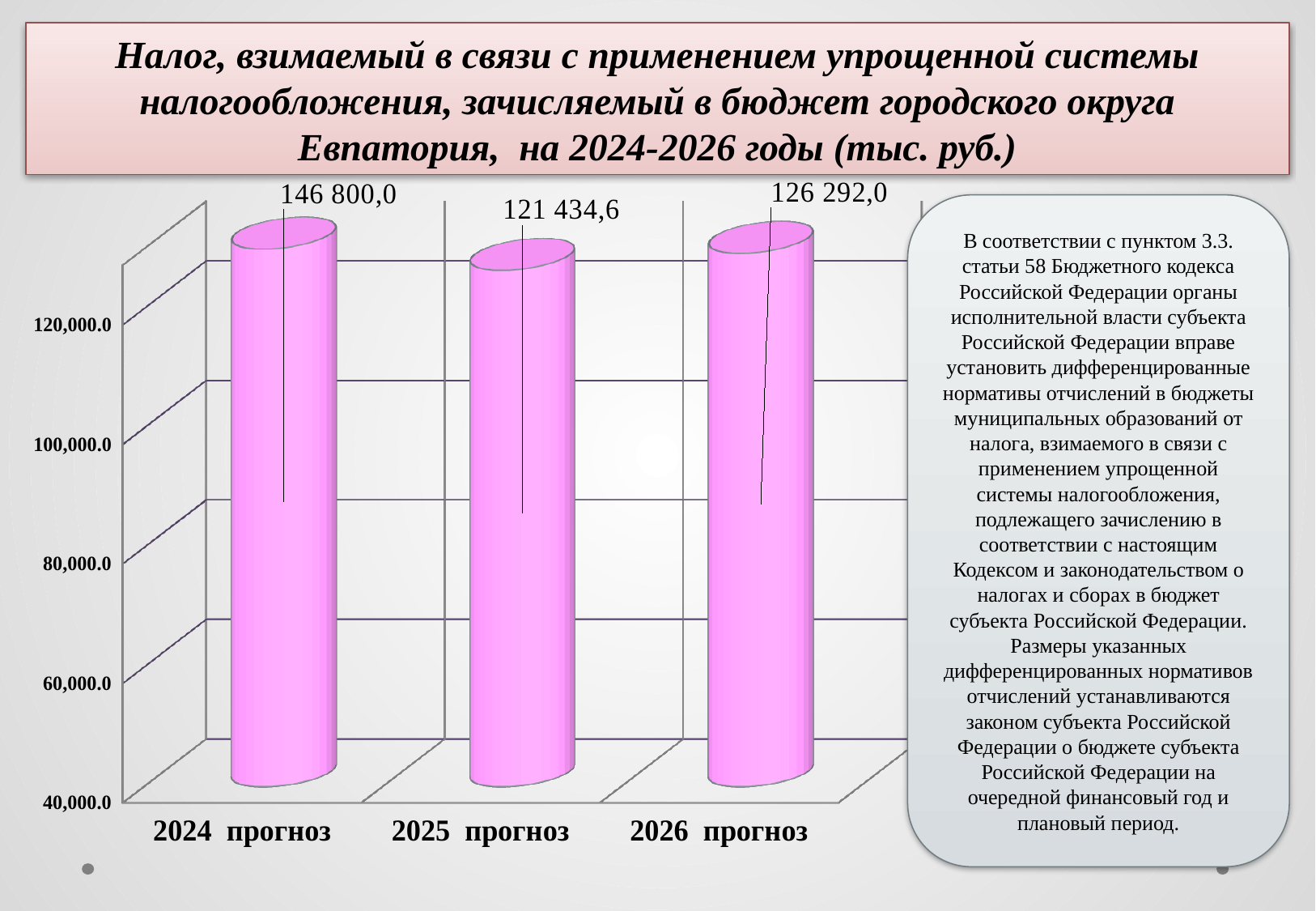
What is the value for 2026 прогноз? 126 292,0 Which category has the lowest value? 2025 прогноз Does the value rise or fall from 2024 прогноз to 2025 прогноз? fall What is the value for 2025 прогноз? 121 434,6 What is the difference between the values for 2026 прогноз and 2025 прогноз? 4 857,4 Is the value for 2024 прогноз greater or less than 120,000.0? greater Which is larger, the value for 2026 прогноз or the value for 2025 прогноз? 2026 прогноз What kind of chart is shown on the slide? bar chart What is the difference between the values for 2024 прогноз and 2025 прогноз? 25 365,4 Which category has the highest value? 2024 прогноз How many categories are shown on the x axis? 3 What is the value for 2024 прогноз? 146 800,0